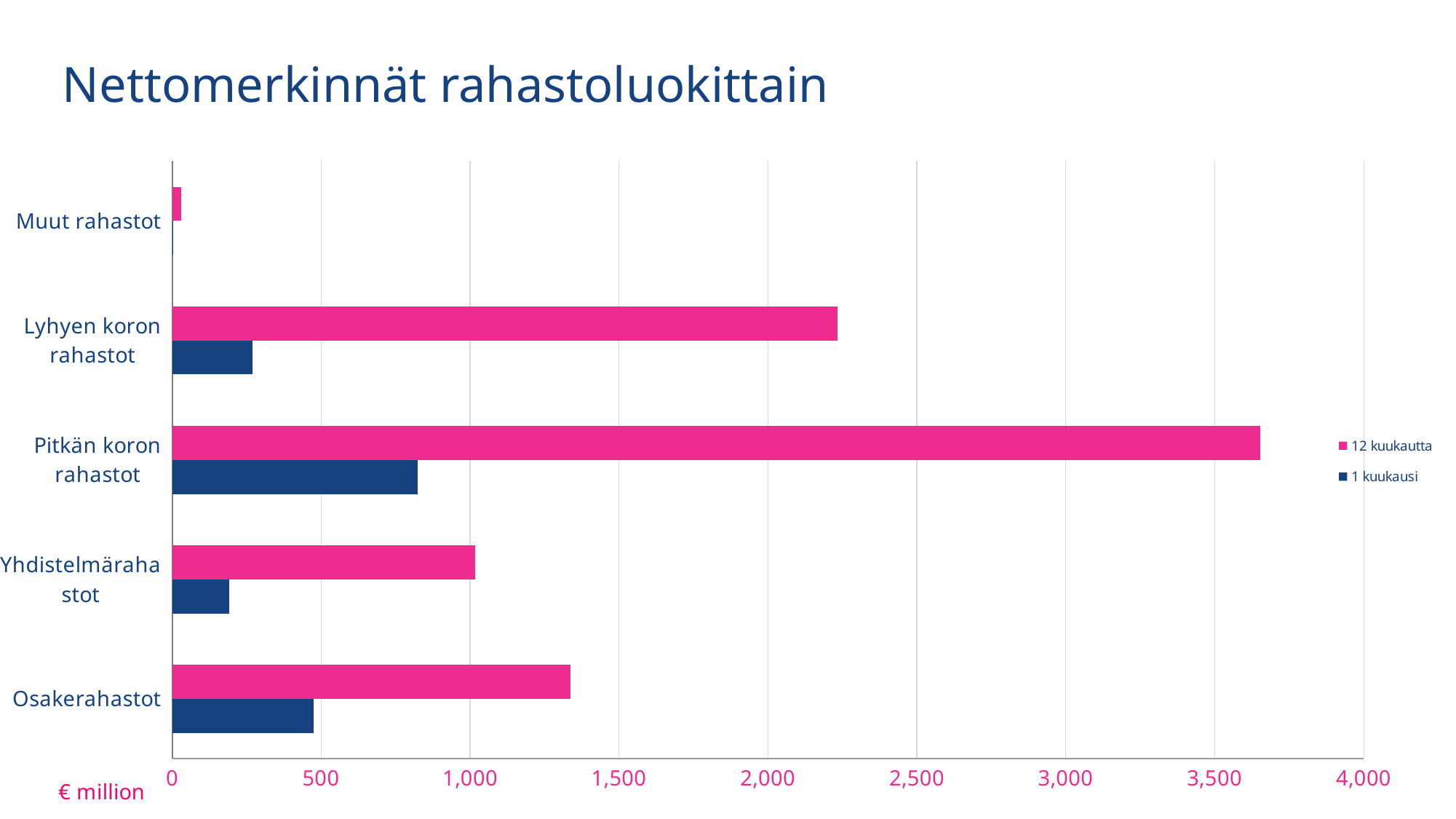
Which category has the highest value for the 12 kuukautta series? Pitkän koron rahastot Is the 1 kuukausi value for Pitkän koron rahastot greater or less than 500? greater For the 12 kuukautta series, which is larger: Osakerahastot or Yhdistelmärahastot? Osakerahastot Which category has the highest value for the 1 kuukausi series? Pitkän koron rahastot What unit is shown for the horizontal axis? € million Is the 12 kuukautta value for Pitkän koron rahastot greater or less than 3,500? greater How many series does the legend list? 2 Which category has the lowest value for the 12 kuukautta series? Muut rahastot What kind of chart is shown on the slide? bar chart What is the title of the chart? Nettomerkinnät rahastoluokittain How many fund categories are shown on the chart? 5 Is the 12 kuukautta value for Lyhyen koron rahastot greater or less than 2,000? greater